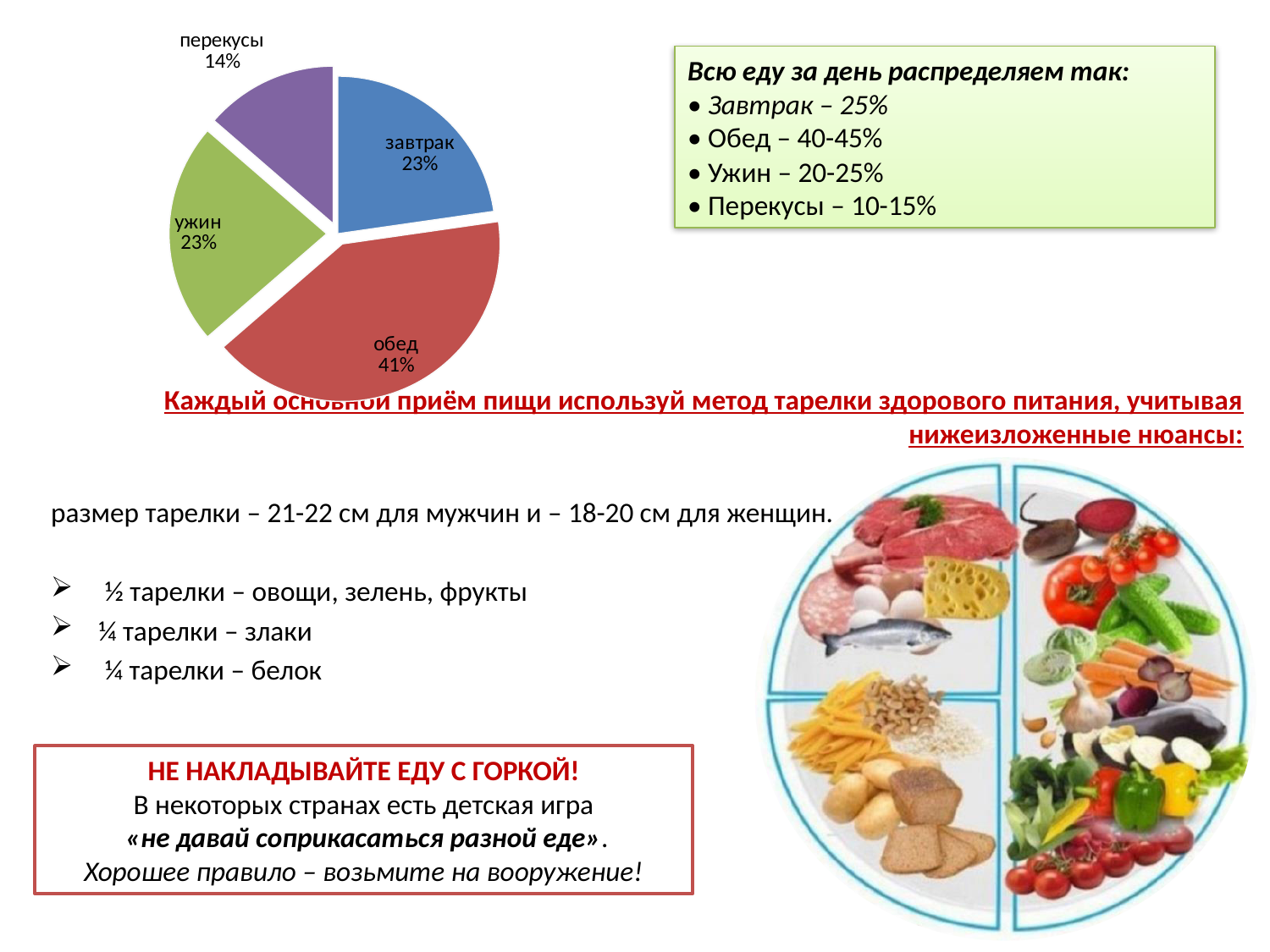
Which slice of the pie chart is the smallest? перекусы What percentage does the ужин slice show? 23% Which slice of the pie chart is the largest? обед How many slices does the pie chart have? 4 By how many percentage points does обед exceed перекусы? 27 What share of the pie does обед take? 41% What colour is the обед slice in the pie chart? red What type of chart is shown on the slide? pie chart What percentage does the завтрак slice show? 23% What percentage does the перекусы slice show? 14% What percentage does the обед slice show? 41% Which is larger, the обед slice or the ужин slice? обед